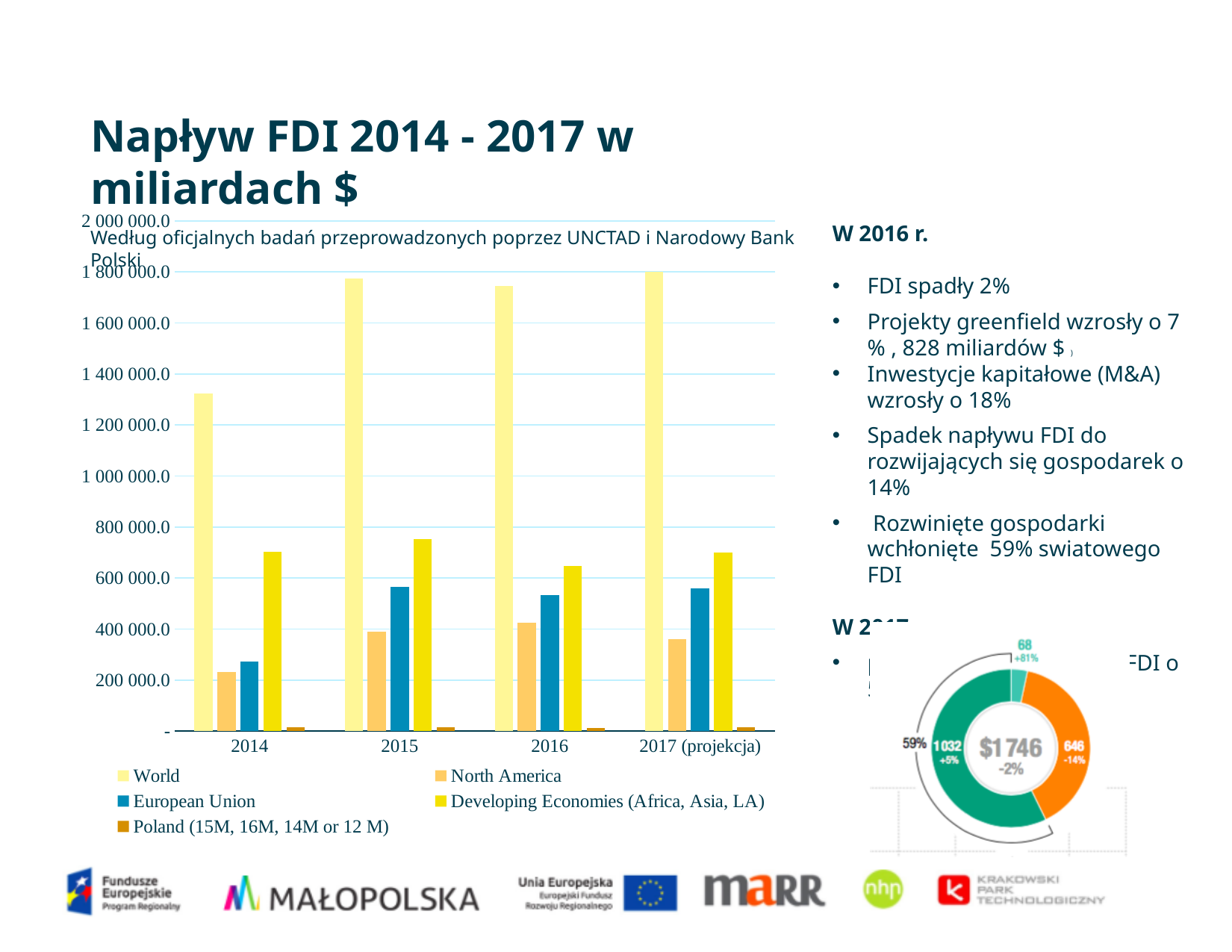
Which series has the lowest bar in 2016? Poland (15M, 16M, 14M or 12 M) What is the title of the slide containing the bar chart? Napływ FDI 2014 - 2017 w miliardach $ Is the value for North America in 2014 greater or less than 400 000.0? less In 2015, which is larger: the European Union bar or the North America bar? European Union Which series has the highest bar in 2014? World How many series does the legend of the bar chart list? 5 How many year categories are shown on the x axis of the bar chart? 4 In 2014, which is larger: the Developing Economies (Africa, Asia, LA) bar or the European Union bar? Developing Economies (Africa, Asia, LA) Is the value for Developing Economies (Africa, Asia, LA) in 2015 greater or less than 600 000.0? greater What kind of chart is shown on the slide? bar chart Is the value for World in 2014 greater or less than 1 200 000.0? greater